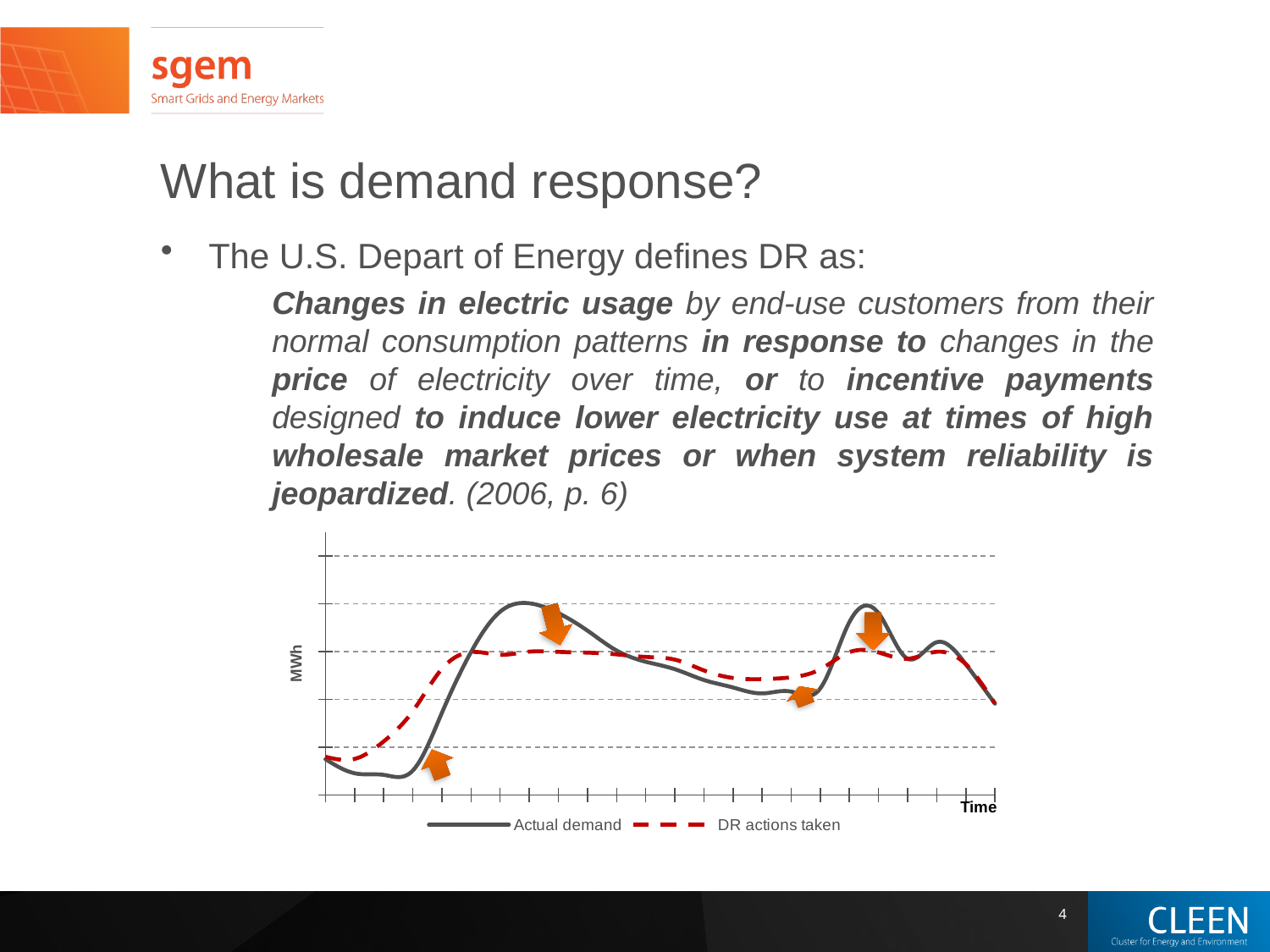
Which series has the lower value at the very start of the time axis, Actual demand or DR actions taken? Actual demand Which series is drawn as a red dashed line? DR actions taken Does the DR actions taken line rise or fall over the first part of the time axis, before the first peak of Actual demand? rise How many orange arrows are drawn on the chart? 4 How many series does the chart legend list? 2 What is the label on the vertical axis of the chart? MWh Which series reaches the higher peak value, Actual demand or DR actions taken? Actual demand Does the Actual demand line rise or fall at the far right end of the time axis? fall What kind of chart is shown on the slide? line chart Which series shows the smoother, flatter profile over time, Actual demand or DR actions taken? DR actions taken What is the label on the horizontal axis of the chart? Time What are the two series named in the chart legend? Actual demand and DR actions taken